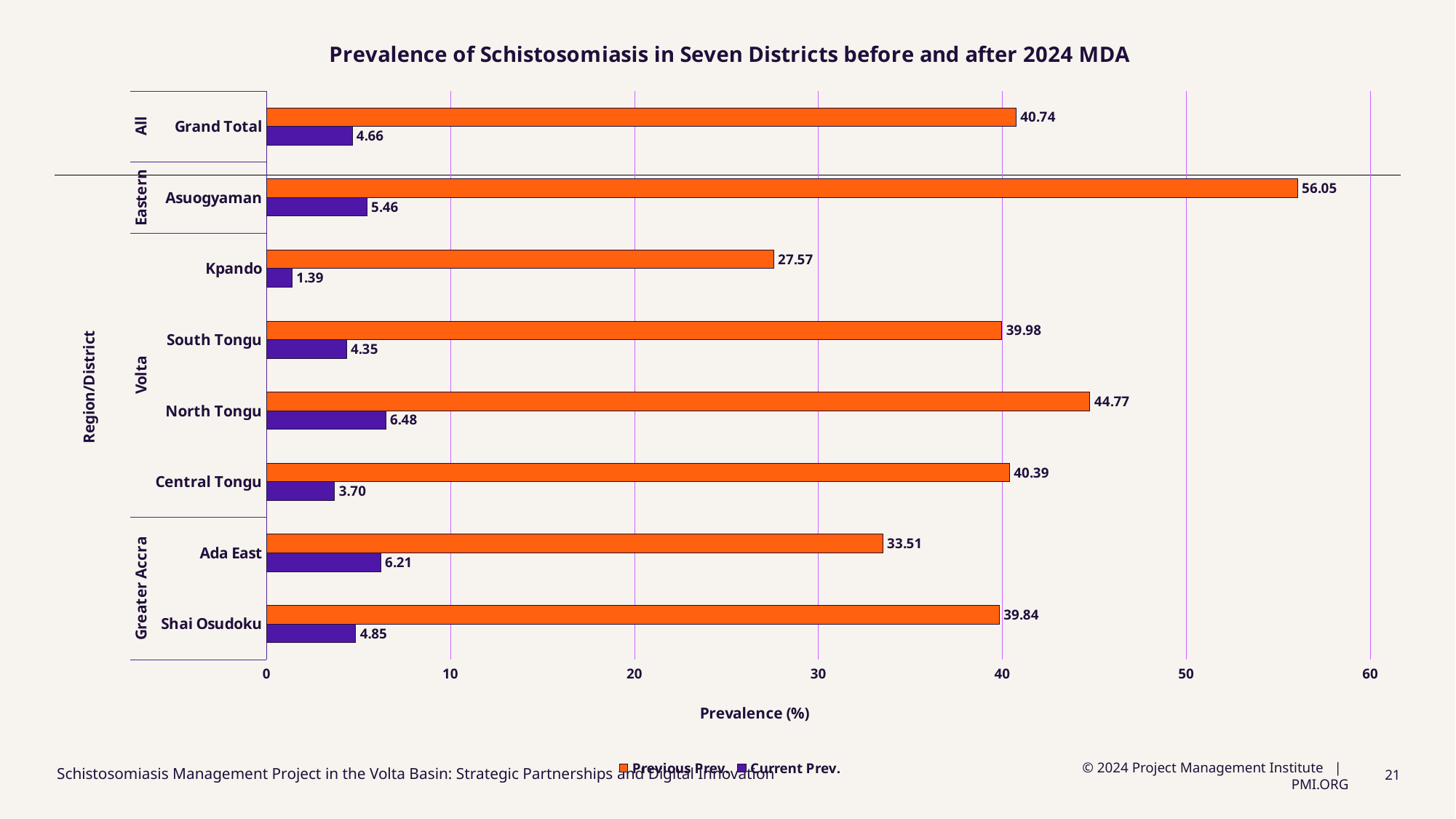
What is the label of the horizontal axis? Prevalence (%) What is the Current Prev. value for Kpando? 1.39 How many series does the legend list? 2 Which is larger, the Current Prev. value for Ada East or for Shai Osudoku? Ada East Which district has the lowest Current Prev. value? Kpando What is the Previous Prev. value for Asuogyaman? 56.05 What is the difference between the Previous Prev. and Current Prev. values for North Tongu? 38.29 What kind of chart is shown on the slide? bar chart Which district has the highest Previous Prev. value? Asuogyaman What is the Current Prev. value for Grand Total? 4.66 Is the Previous Prev. value for Kpando greater or less than 30? less How many categories (including Grand Total) are shown on the chart? 8